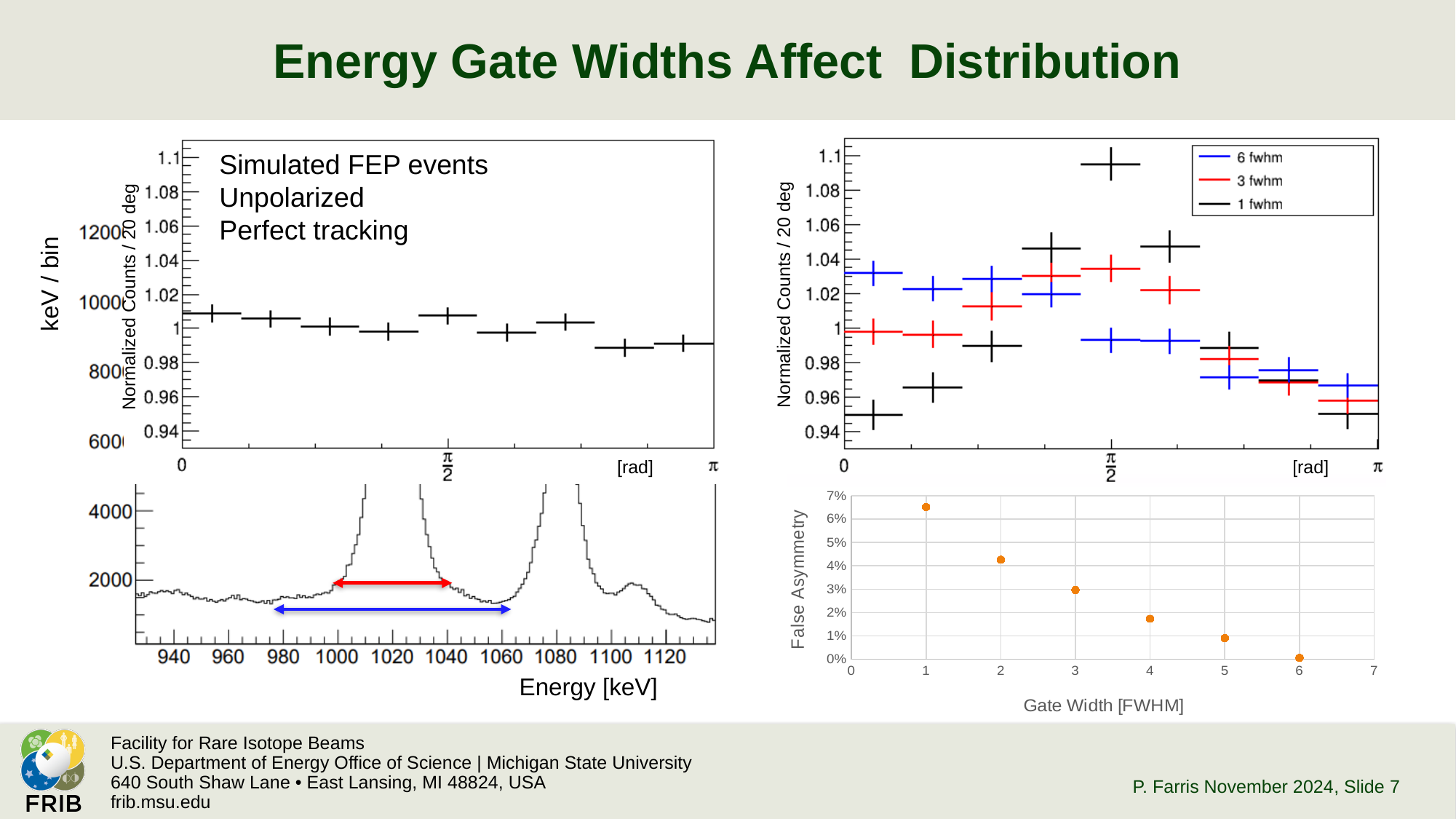
In the bottom-right False Asymmetry chart, does the false asymmetry rise or fall as gate width increases? fall In the bottom-right False Asymmetry chart, is the value at gate width 1 greater or less than 6%? greater In the bottom-right chart, what is the x-axis title? Gate Width [FWHM] In the top-right chart, how many series does the legend list? 3 What type of chart is the bottom-right chart of False Asymmetry versus Gate Width? scatter plot In the bottom-right False Asymmetry chart, is the value at gate width 2 greater or less than 4%? greater In the top-right chart, which series is drawn in red according to the legend? 3 fwhm In the bottom-right False Asymmetry chart, which gate width has the highest false asymmetry? 1 In the top-right chart, in the first angular bin (nearest 0), which series has the larger value: 6 fwhm or 1 fwhm? 6 fwhm In the bottom-right False Asymmetry chart, which gate width has the lowest false asymmetry? 6 In the bottom-right False Asymmetry chart, how many data points are plotted? 6 In the bottom-right False Asymmetry chart, is the value at gate width 6 greater or less than 1%? less